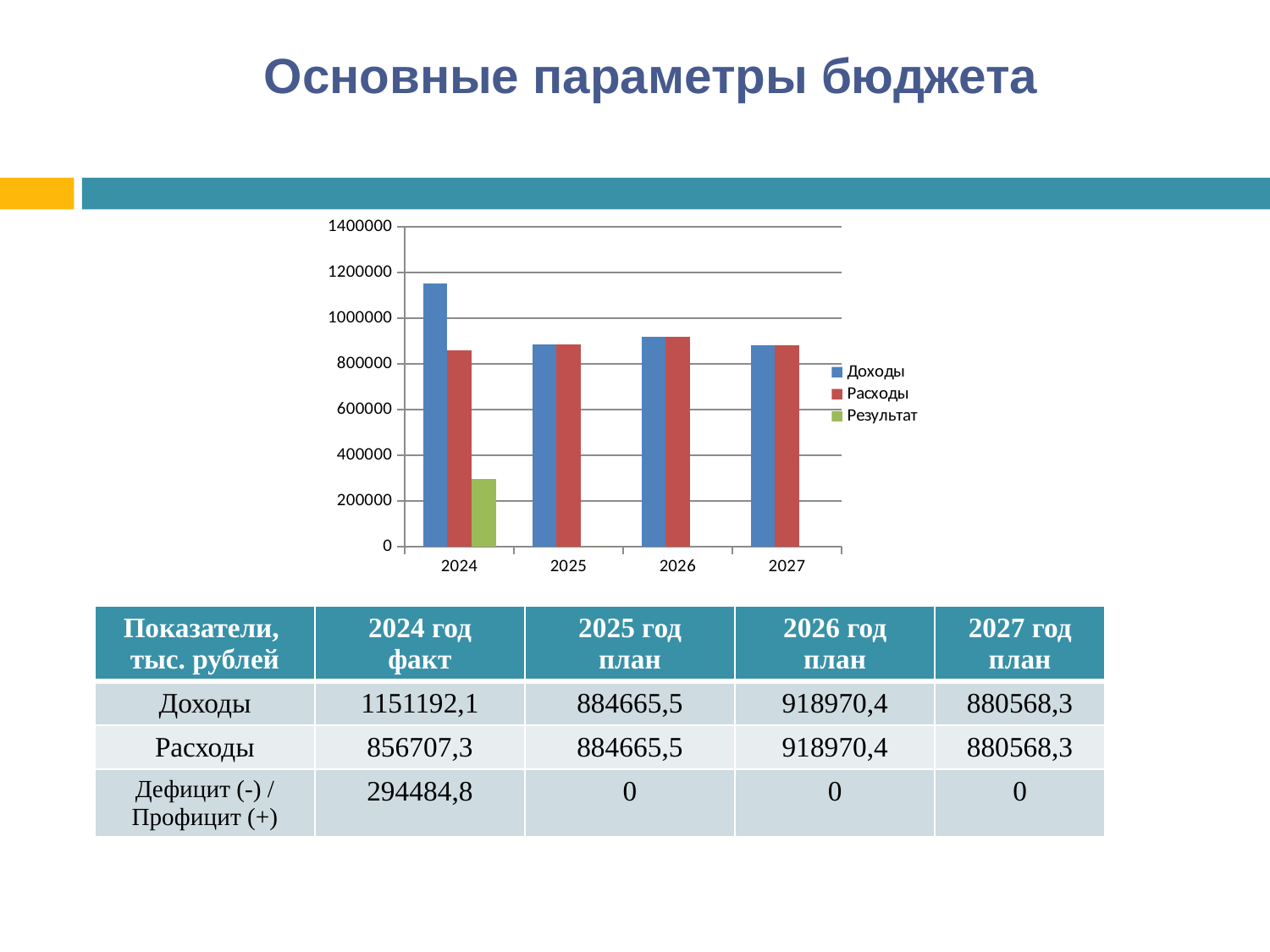
Which series in the legend is shown in green? Результат What kind of chart is shown on the slide? bar chart According to the table, what is the difference between Доходы and Расходы in 2024? 294484,8 How many series does the chart legend list? 3 Which year has the highest Доходы bar in the chart? 2024 Is the Доходы value for 2024 greater or less than 1000000? greater Is the Расходы value for 2025 greater or less than 1000000? less According to the table, what is the Расходы value for 2026? 918970,4 Which is larger in 2024, Доходы or Расходы? Доходы How many years are shown on the x axis of the chart? 4 According to the table, what is the Доходы value for 2024? 1151192,1 Is the Результат value for 2024 greater or less than 400000? less